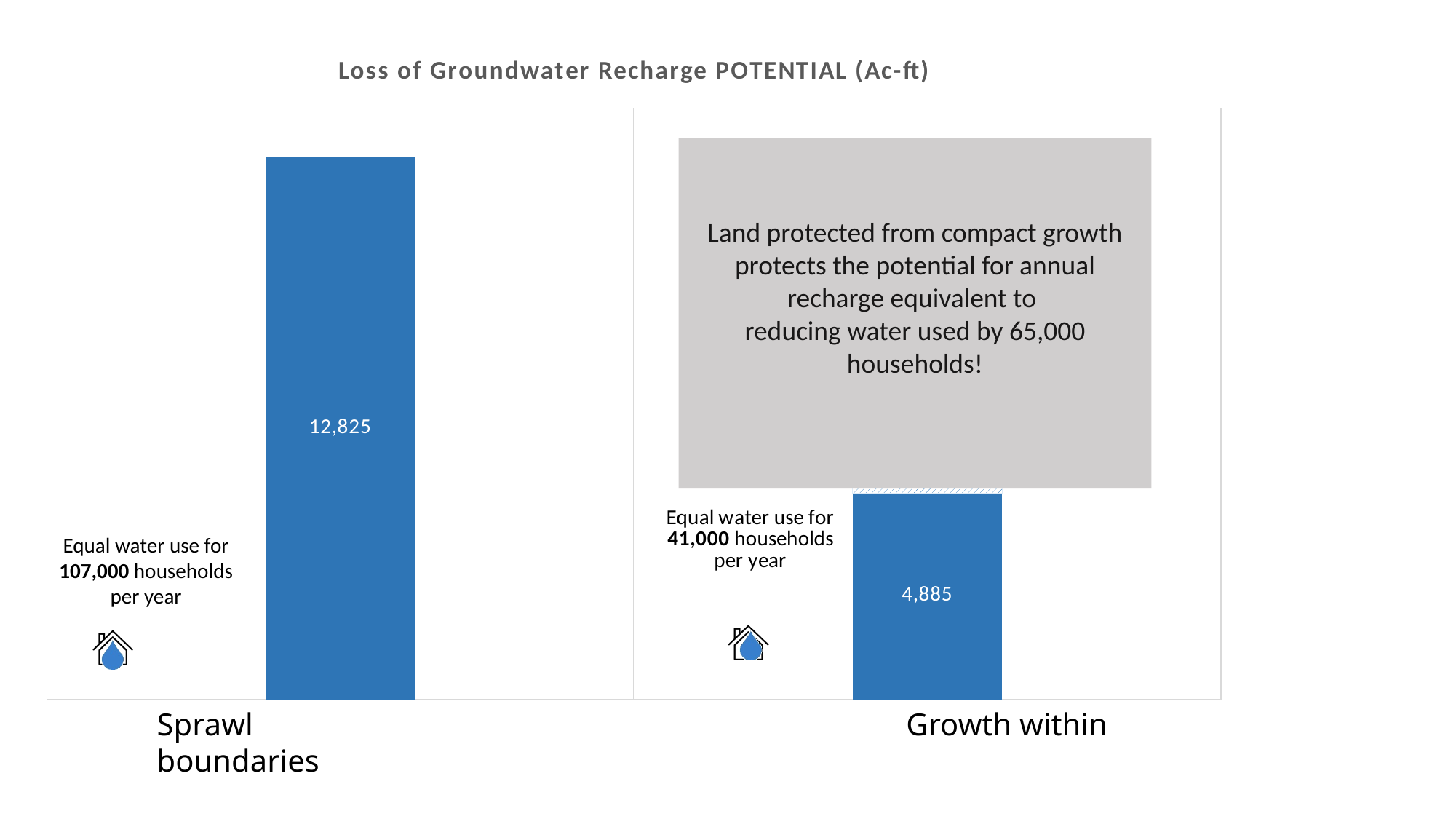
What is the difference between the values for Sprawl boundaries and Growth within? 7,940 Which is larger, the value for Sprawl boundaries or the value for Growth within? Sprawl boundaries How many categories are shown in the chart? 2 Which category has the highest loss of groundwater recharge potential? Sprawl boundaries Which category has the lowest loss of groundwater recharge potential? Growth within Do the values fall or rise from Sprawl boundaries to Growth within? Fall What kind of chart is shown on the slide? Bar chart According to the annotation, the Sprawl boundaries value equals water use for how many households per year? 107,000 What is the value for Sprawl boundaries? 12,825 What is the value for Growth within? 4,885 What is the title of the chart? Loss of Groundwater Recharge POTENTIAL (Ac-ft)